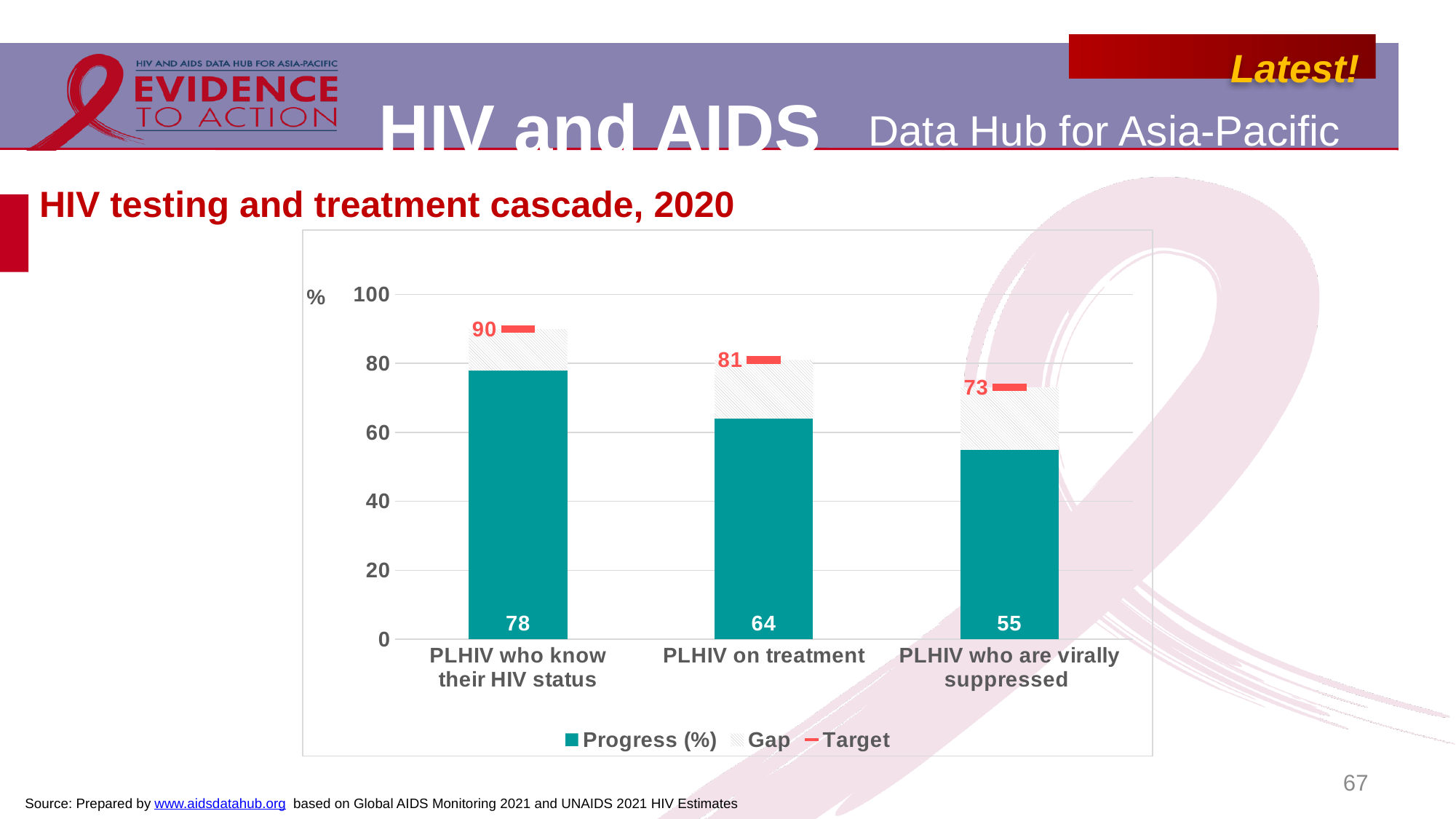
Which is larger: the Progress (%) value for PLHIV on treatment or for PLHIV who are virally suppressed? PLHIV on treatment What is the difference between the Target and the Progress (%) value for PLHIV who know their HIV status? 12 What is the Progress (%) value for PLHIV who know their HIV status? 78 How many series does the legend list? 3 What is the Progress (%) value for PLHIV on treatment? 64 How many categories are shown on the x axis? 3 Do the Progress (%) values rise or fall from left to right along the x axis? fall Which category has the lowest Target value? PLHIV who are virally suppressed Which category has the highest Progress (%) value? PLHIV who know their HIV status What is the Target value for PLHIV who are virally suppressed? 73 What is the Progress (%) value for PLHIV who are virally suppressed? 55 What is the Target value for PLHIV on treatment? 81